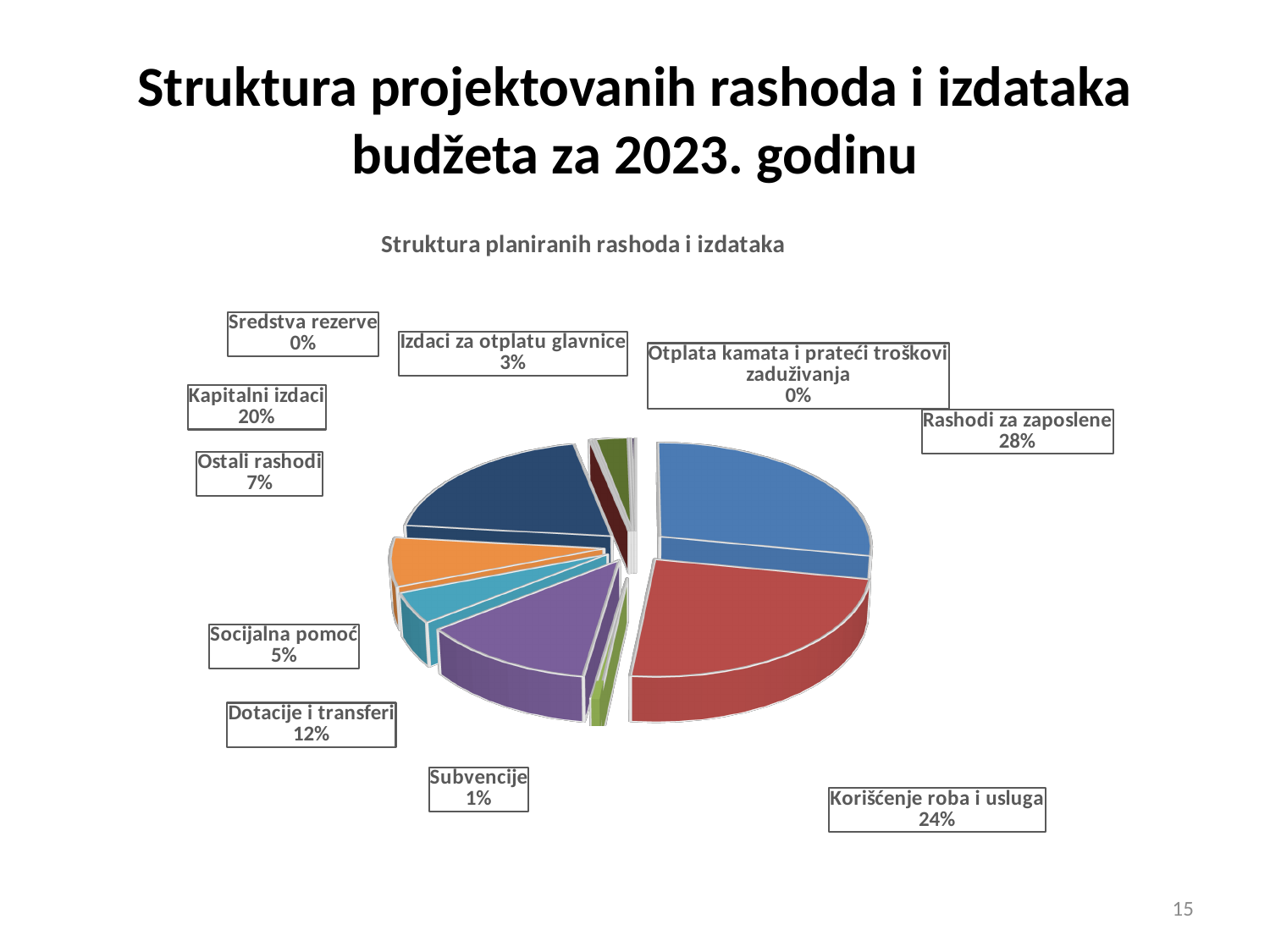
What is the difference between the shares of Rashodi za zaposlene and Korišćenje roba i usluga? 4% Which is larger, Ostali rashodi or Socijalna pomoć? Ostali rashodi What share of the pie is Korišćenje roba i usluga? 24% Which category has the largest share of the pie? Rashodi za zaposlene What kind of chart is shown on the slide? Pie chart What is the value shown for Kapitalni izdaci? 20% What is the value shown for Dotacije i transferi? 12% What is the value shown for Socijalna pomoć? 5% What is the chart's title? Struktura planiranih rashoda i izdataka How many categories are shown in the pie chart? 10 What share of the pie is Rashodi za zaposlene? 28% What is the value shown for Izdaci za otplatu glavnice? 3%